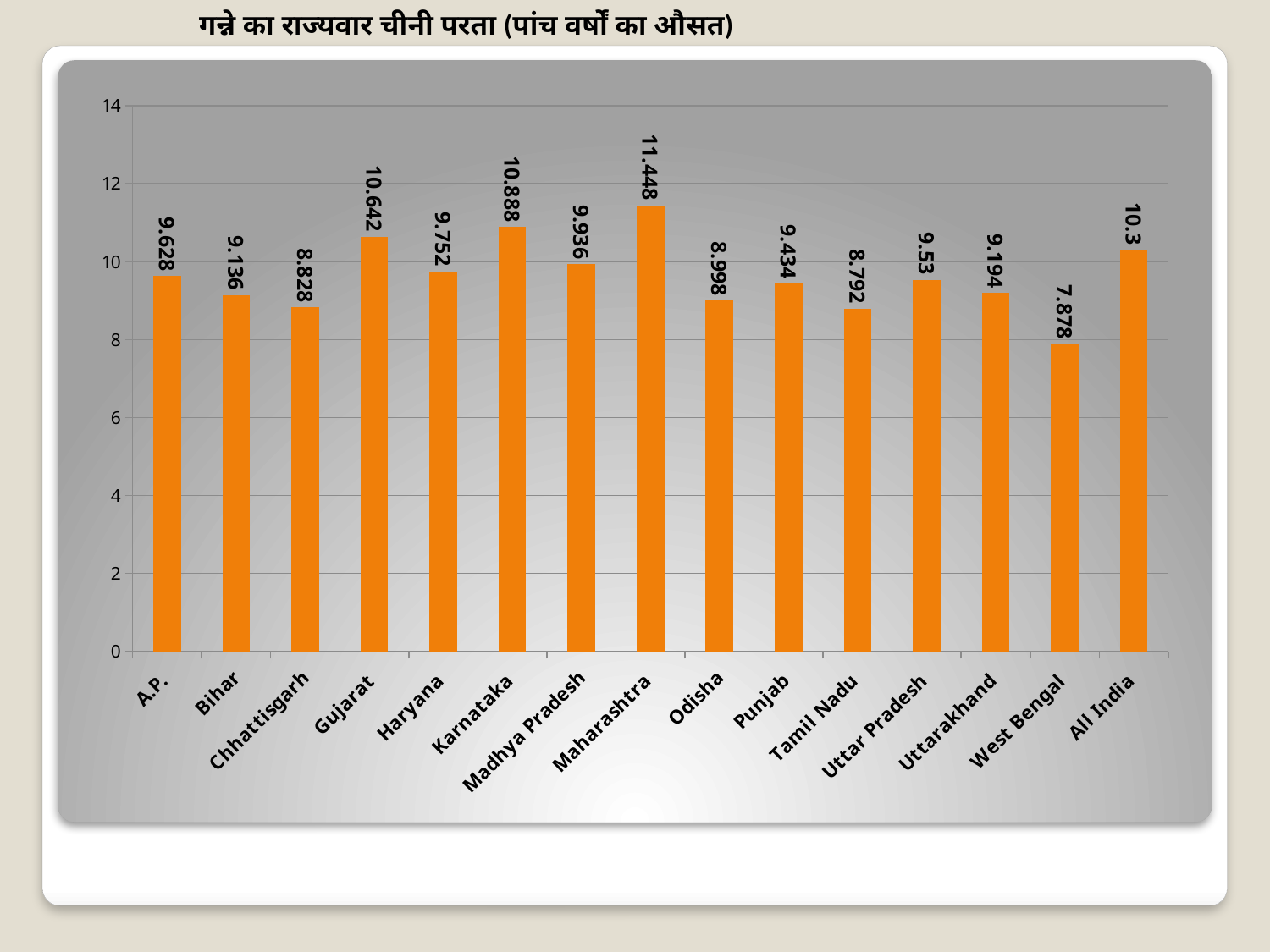
What is the value shown for Maharashtra? 11.448 Is the value for Tamil Nadu greater or less than 10? less Which has a larger value, Haryana or Punjab? Haryana What is the value shown for West Bengal? 7.878 Which category has the highest value? Maharashtra Which category has the lowest value? West Bengal What colour are the bars in the chart? Orange What kind of chart is shown on the slide? Bar chart What is the value shown for All India? 10.3 What is the value shown for Uttar Pradesh? 9.53 How many categories are shown on the x axis? 15 What is the difference between the values for Karnataka and Gujarat? 0.246